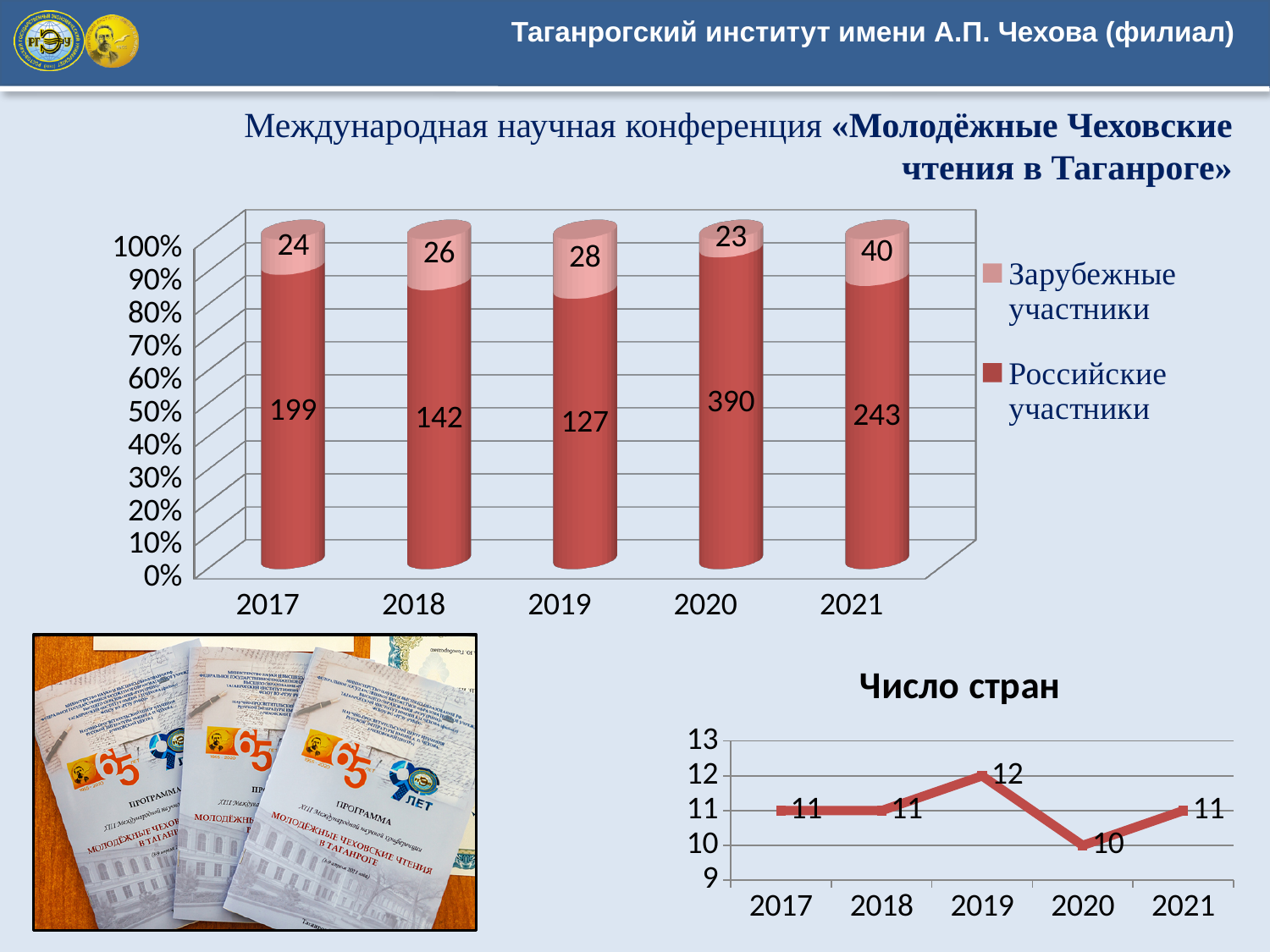
In the top stacked bar chart, what is the total number of participants (Российские plus Зарубежные) in 2017? 223 In the top stacked bar chart, what is the difference between Российские участники in 2020 and in 2019? 263 In the 'Число стран' chart, does the value rise or fall from 2019 to 2020? Fall In the 'Число стран' chart, what is the value for 2019? 12 In the top stacked bar chart, which year had the highest number of Российские участники? 2020 In the top stacked bar chart, how many Российские участники were there in 2020? 390 What kind of chart is the 'Число стран' chart at the bottom right? Line chart In the top stacked bar chart, how many Зарубежные участники were there in 2021? 40 In the top stacked bar chart, how many series does the legend list? 2 In the top stacked bar chart, which year had the lowest number of Зарубежные участники? 2020 In the 'Число стран' chart, which year has the lowest value? 2020 In the top stacked bar chart, how many years are shown on the x axis? 5